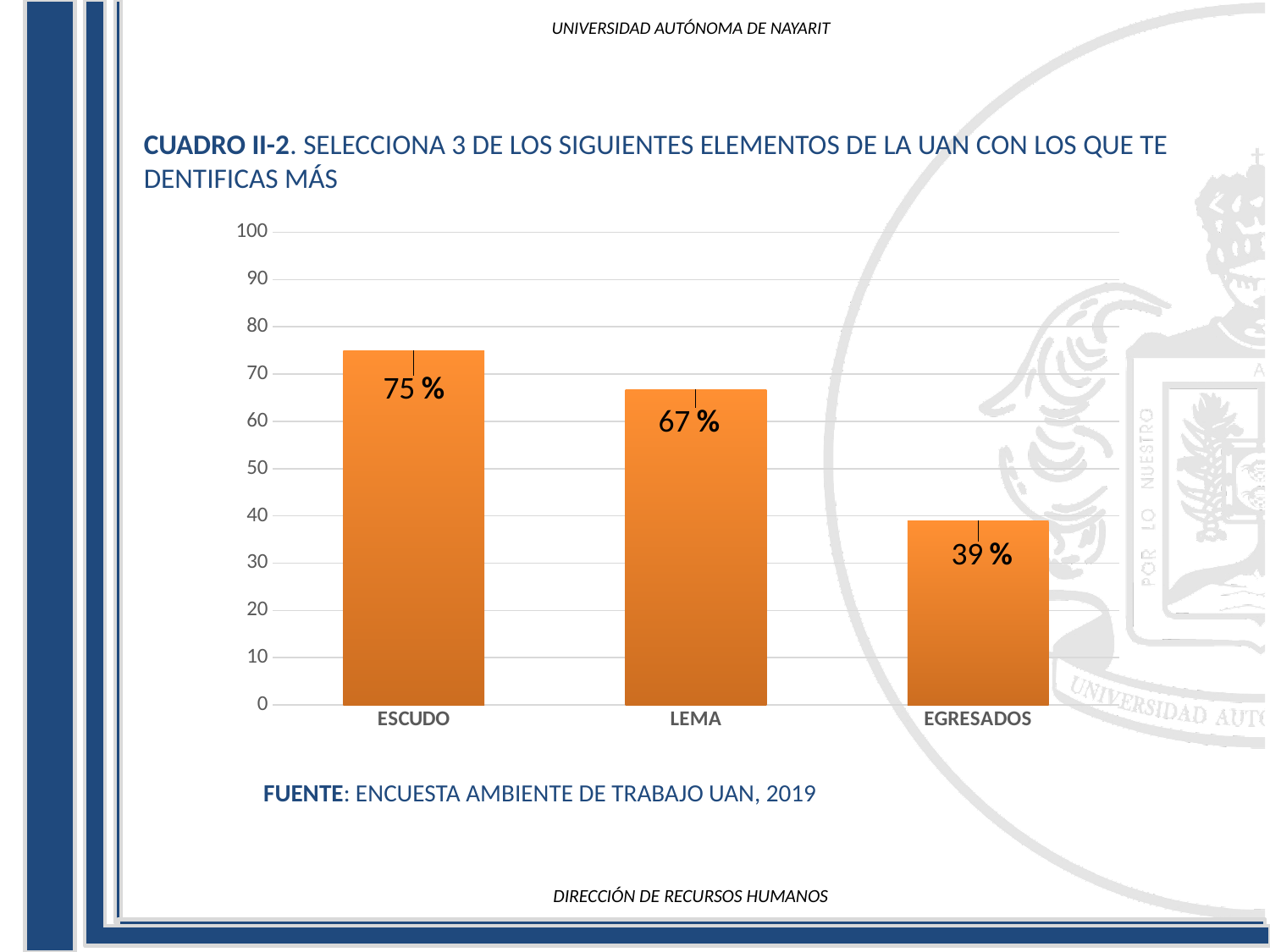
What is the value for EGRESADOS? 39 % What is the difference between the values for ESCUDO and LEMA? 8 % What is the difference between the values for LEMA and EGRESADOS? 28 % What kind of chart is shown on the slide? bar chart Is the value for EGRESADOS greater or less than 50? less How many categories are shown in the chart? 3 Which category has the lowest value? EGRESADOS What is the value for LEMA? 67 % Do the values rise or fall from left to right across the categories? fall Which category has the highest value? ESCUDO What is the value for ESCUDO? 75 % Which is larger, the value for LEMA or the value for EGRESADOS? LEMA